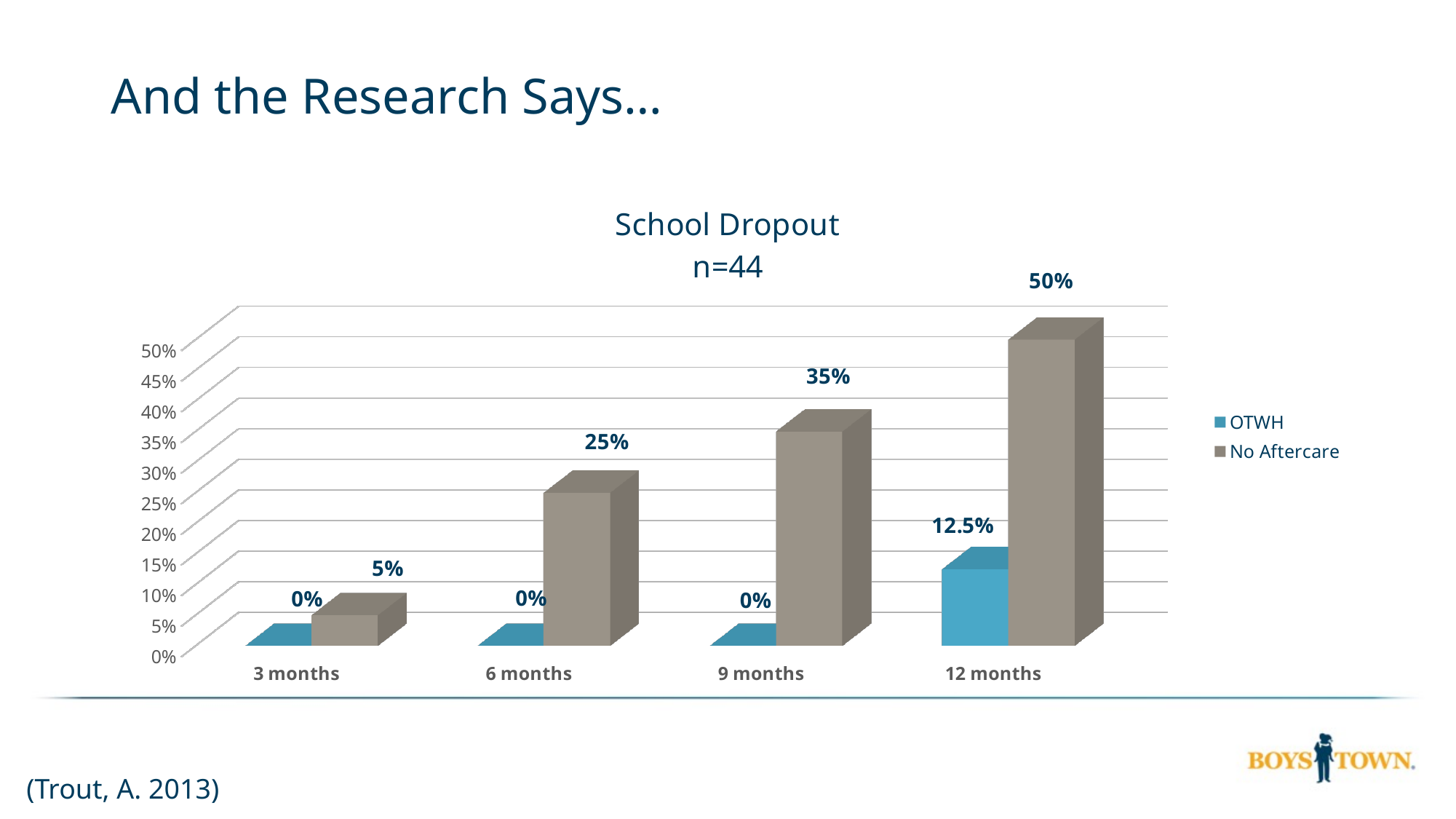
At which time point is the No Aftercare value lowest? 3 months Do the No Aftercare values rise or fall from 3 months to 12 months? rise How many time points are shown on the x axis? 4 Which is larger at 9 months, the OTWH value or the No Aftercare value? No Aftercare What is the OTWH value at 9 months? 0% What is the difference between the No Aftercare and OTWH values at 12 months? 37.5% What is the OTWH value at 12 months? 12.5% What is the No Aftercare value at 12 months? 50% How many series does the legend list? 2 What is the difference between the No Aftercare values at 9 months and 6 months? 10% What is the No Aftercare value at 6 months? 25% At which time point is the No Aftercare value highest? 12 months